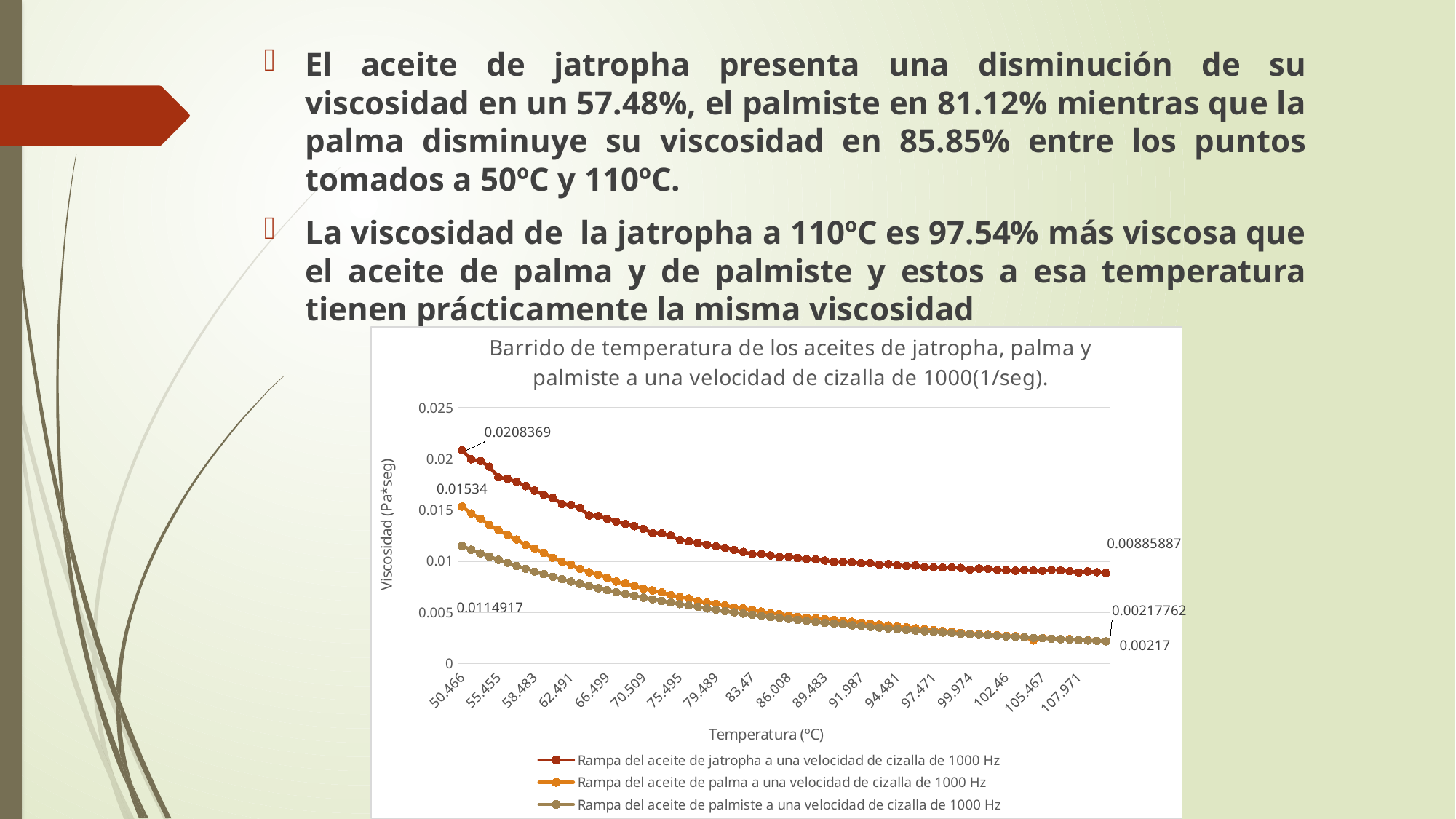
Do the viscosity values rise or fall as temperature increases along the x axis? fall How many series does the legend list? 3 What is the label of the y axis? Viscosidad (Pa*seg) What is the first labelled viscosity value of the jatropha oil series? 0.0208369 What is the first labelled viscosity value of the palma oil series? 0.01534 What type of chart is shown on the slide? line chart Which series has the highest viscosity at the start of the temperature sweep? Rampa del aceite de jatropha a una velocidad de cizalla de 1000 Hz What is the last labelled viscosity value of the jatropha oil series? 0.00885887 What is the first labelled viscosity value of the palmiste oil series? 0.0114917 Is the jatropha oil viscosity at the end of the sweep greater or less than 0.01? less